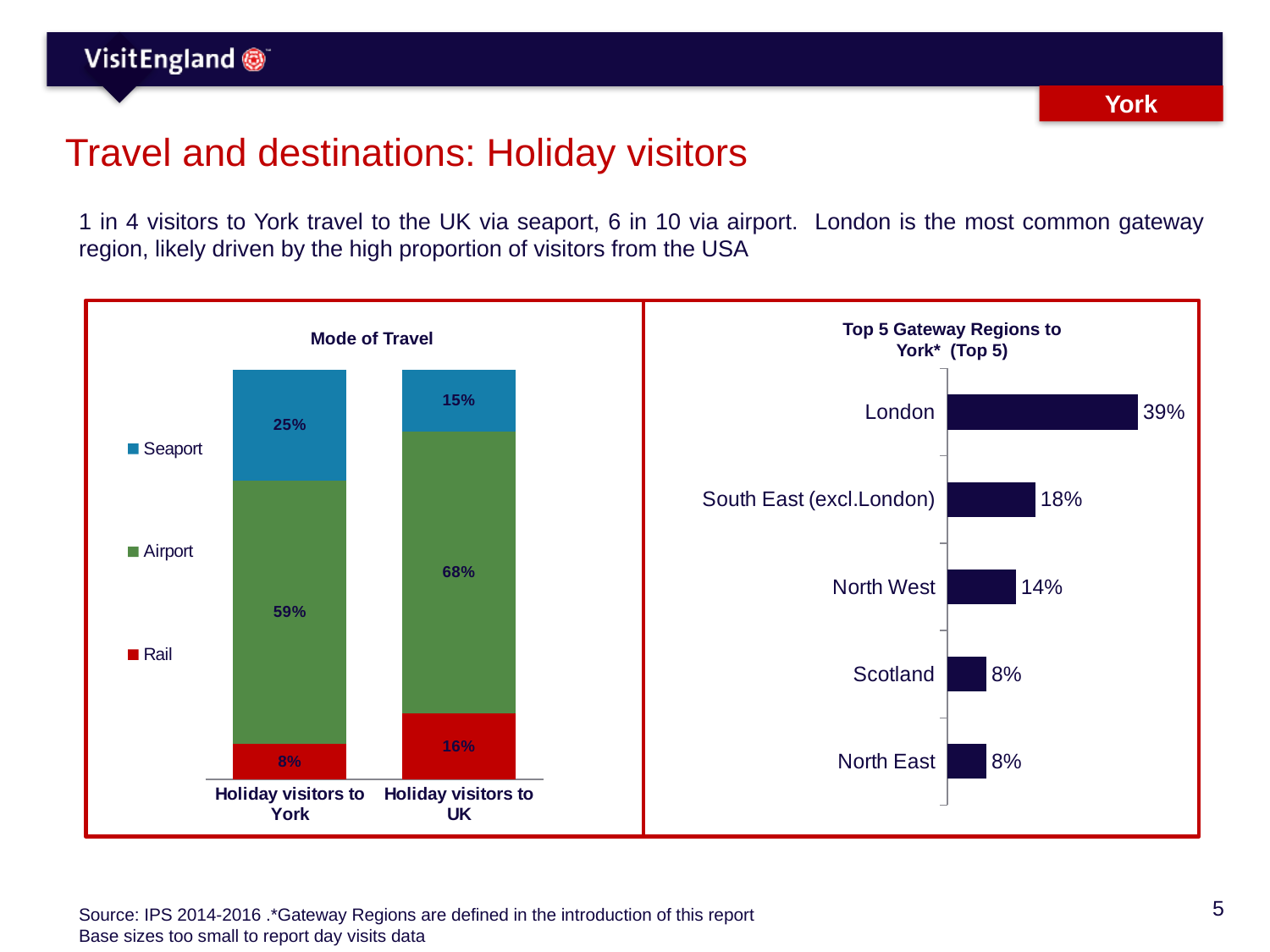
In the Mode of Travel chart, which is larger: the seaport share for holiday visitors to York or for holiday visitors to the UK? Holiday visitors to York In the Mode of Travel chart, what is the difference between the rail share for holiday visitors to the UK and for holiday visitors to York? 8% How many regions are shown in the Top 5 Gateway Regions to York chart? 5 In the Top 5 Gateway Regions to York chart, what is the value for South East (excl.London)? 18% In the Mode of Travel chart, what percentage of holiday visitors to York travel by rail? 8% In the Top 5 Gateway Regions to York chart, which region has the highest value? London In the Mode of Travel chart, what percentage of holiday visitors to York travel via seaport? 25% How many series does the legend of the Mode of Travel chart list? 3 In the Mode of Travel chart, which colour represents Airport in the legend? Green In the Mode of Travel chart, what percentage of holiday visitors to the UK travel via airport? 68% In the Top 5 Gateway Regions to York chart, what is the difference between London and North West? 25% What kind of chart is the Mode of Travel chart? Stacked bar chart